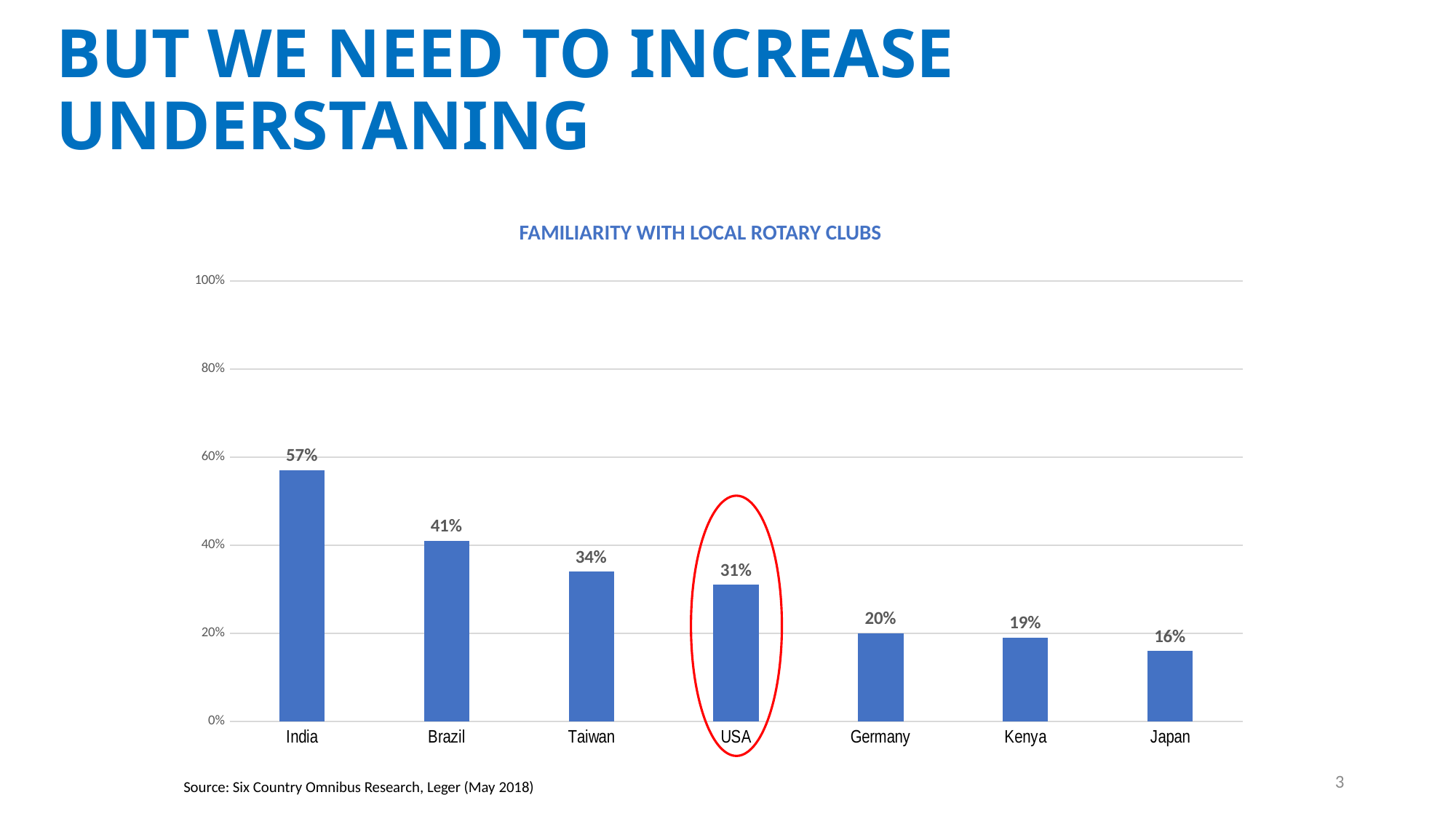
What is the familiarity with local Rotary clubs value for India? 57% Which country has the highest familiarity with local Rotary clubs? India What kind of chart is shown on the slide? Bar chart What is the difference between the values for Taiwan and the USA? 3% What is the value shown for the USA? 31% Which country has the lowest familiarity with local Rotary clubs? Japan How many countries are shown in the chart? 7 What is the difference between the values for India and Brazil? 16% Is the value for Germany greater or less than 40%? less What is the title of the chart? FAMILIARITY WITH LOCAL ROTARY CLUBS What is the value shown for Kenya? 19% Which has a larger value, Brazil or Taiwan? Brazil